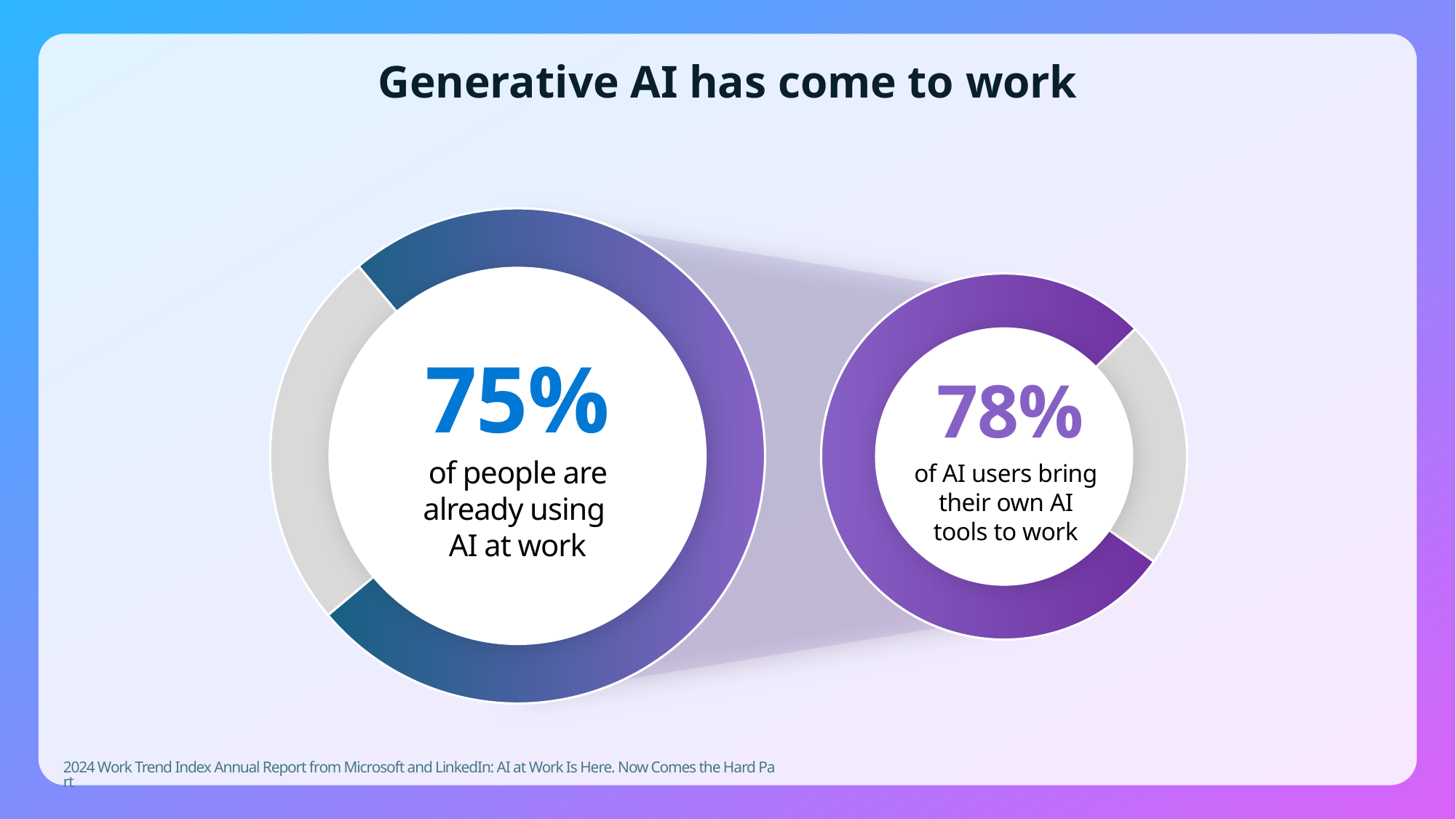
What is the title of the slide containing the two donut charts? Generative AI has come to work On the left donut chart, is the highlighted value greater or less than 50%? greater What colour is the highlighted segment of the right donut chart showing 78%? purple What is the difference in percentage points between the right chart's 78% and the left chart's 75%? 3 percentage points What kind of chart is used to show the 75% figure on the left? donut (pie) chart Which of the two donut charts shows the larger percentage, the left one (people using AI at work) or the right one (AI users bringing their own tools)? the right one (78%) On the left donut chart, what share of the ring is left unfilled (grey) given the 75% highlighted? 25% On the left donut chart, what percentage of people are already using AI at work? 75% On the right donut chart, what share of the ring is left unfilled (grey) given the 78% highlighted? 22% How many donut charts are shown on the slide? 2 On the right donut chart, what percentage of AI users bring their own AI tools to work? 78%